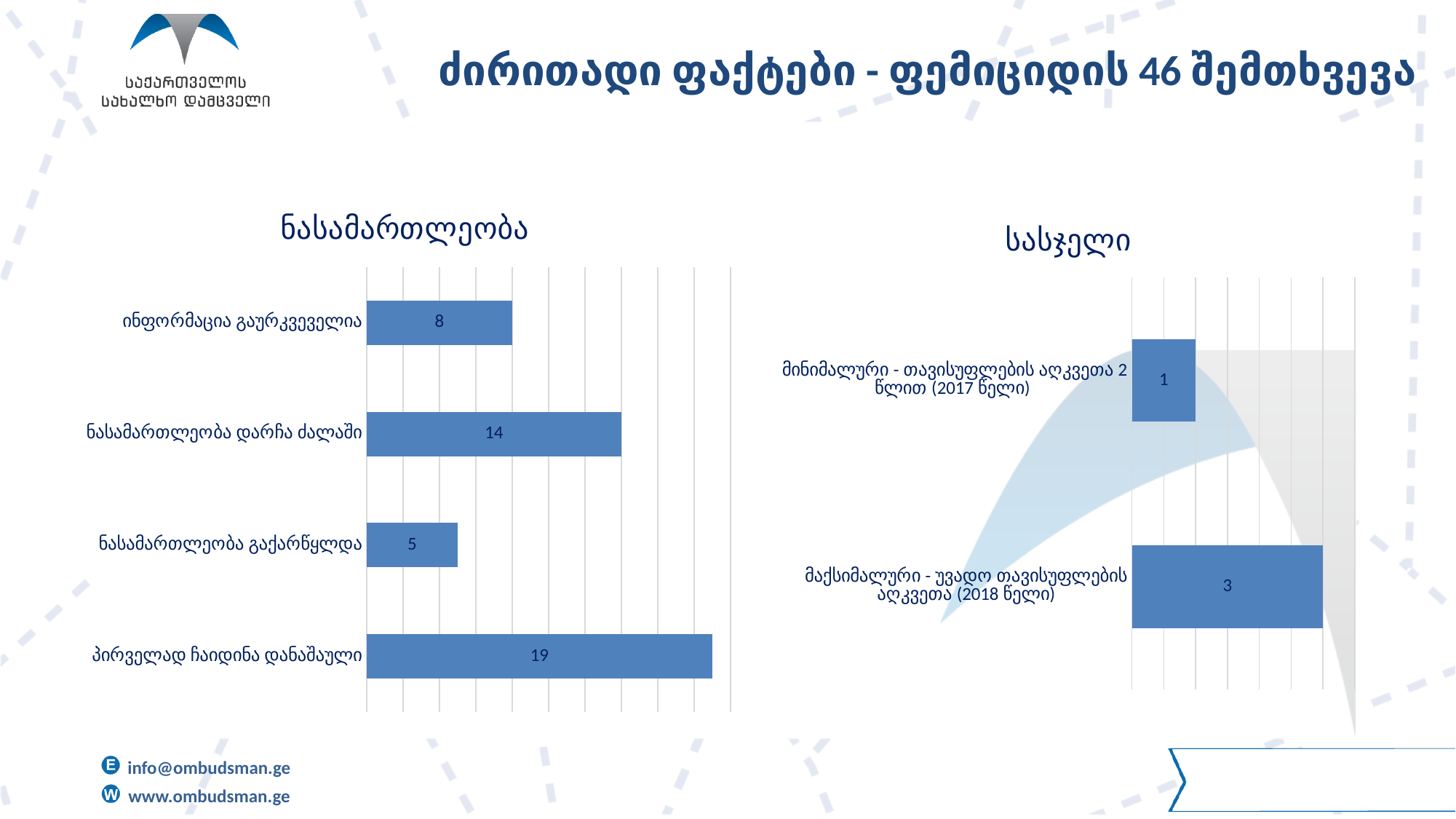
In the chart titled "ნასამართლეობა", which is larger: "ინფორმაცია გაურკვეველია" or "ნასამართლეობა დარჩა ძალაში"? ნასამართლეობა დარჩა ძალაში In the chart titled "ნასამართლეობა", what is the difference between the values for "პირველად ჩაიდინა დანაშაული" and "ნასამართლეობა დარჩა ძალაში"? 5 In the chart titled "ნასამართლეობა", which category has the lowest value? ნასამართლეობა გაქარწყლდა In the chart titled "ნასამართლეობა", what is the value for "ინფორმაცია გაურკვეველია"? 8 In the chart titled "ნასამართლეობა", what is the value for "ნასამართლეობა გაქარწყლდა"? 5 What kind of chart is the chart titled "სასჯელი"? bar chart In the chart titled "ნასამართლეობა", what is the value for "პირველად ჩაიდინა დანაშაული"? 19 In the chart titled "ნასამართლეობა", which category has the highest value? პირველად ჩაიდინა დანაშაული How many categories are shown in the chart titled "ნასამართლეობა"? 4 In the chart titled "სასჯელი", what is the value for "მაქსიმალური - უვადო თავისუფლების აღკვეთა (2018 წელი)"? 3 In the chart titled "სასჯელი", what is the value for "მინიმალური - თავისუფლების აღკვეთა 2 წლით (2017 წელი)"? 1 How many categories are shown in the chart titled "სასჯელი"? 2